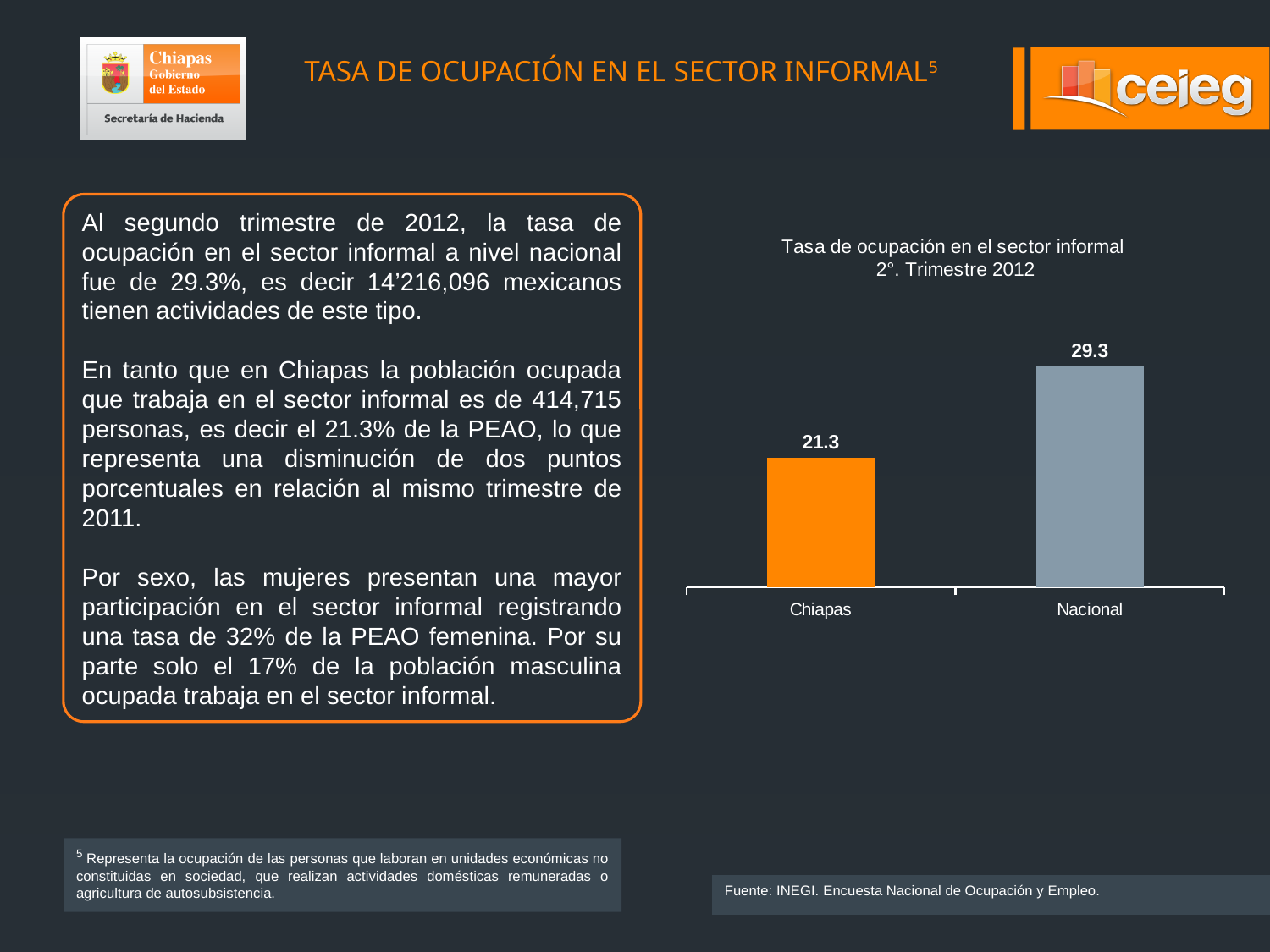
What is the difference between the Nacional and Chiapas values? 8.0 What is the title of the chart? Tasa de ocupación en el sector informal 2°. Trimestre 2012 Which is larger, the value for Chiapas or the value for Nacional? Nacional Which category has the lowest value in the chart? Chiapas What kind of chart is shown on the slide? Bar chart How many categories are shown in the chart? 2 What is the value for Chiapas in the chart? 21.3 What is the value for Nacional in the chart? 29.3 What colour is the bar for Chiapas? Orange Which category has the highest value in the chart? Nacional